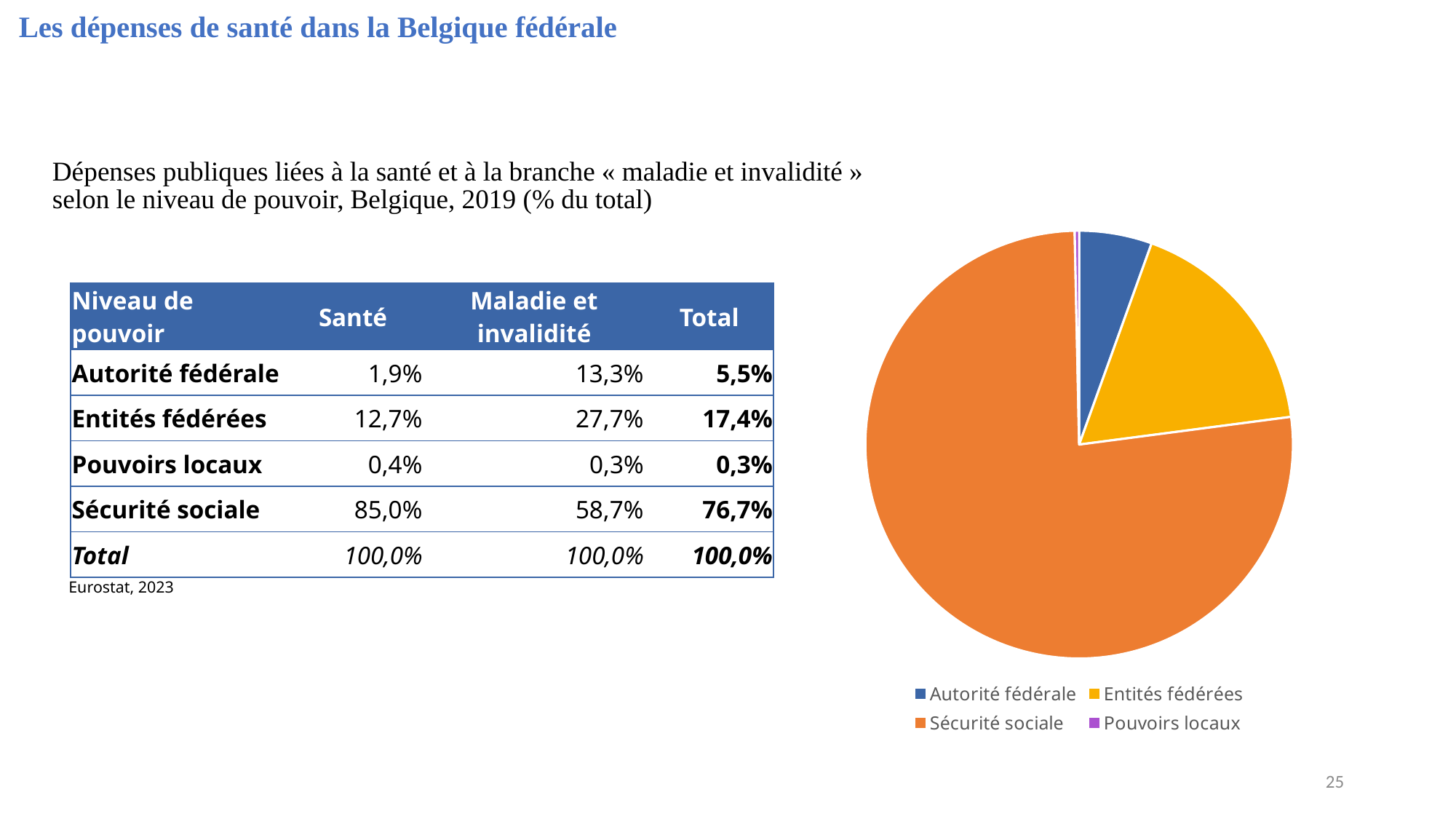
Is the share of Sécurité sociale in the pie chart greater or less than 50%? greater In the pie chart, which slice is larger: Sécurité sociale or Entités fédérées? Sécurité sociale What kind of chart is shown on the right of the slide? pie chart Which category has the largest slice in the pie chart? Sécurité sociale What colour represents Sécurité sociale in the pie chart? orange How many slices does the pie chart have? 4 How many entries does the pie chart's legend list? 4 What colour represents Entités fédérées in the pie chart? yellow In the pie chart, which slice is larger: Entités fédérées or Autorité fédérale? Entités fédérées Which category has the smallest slice in the pie chart? Pouvoirs locaux